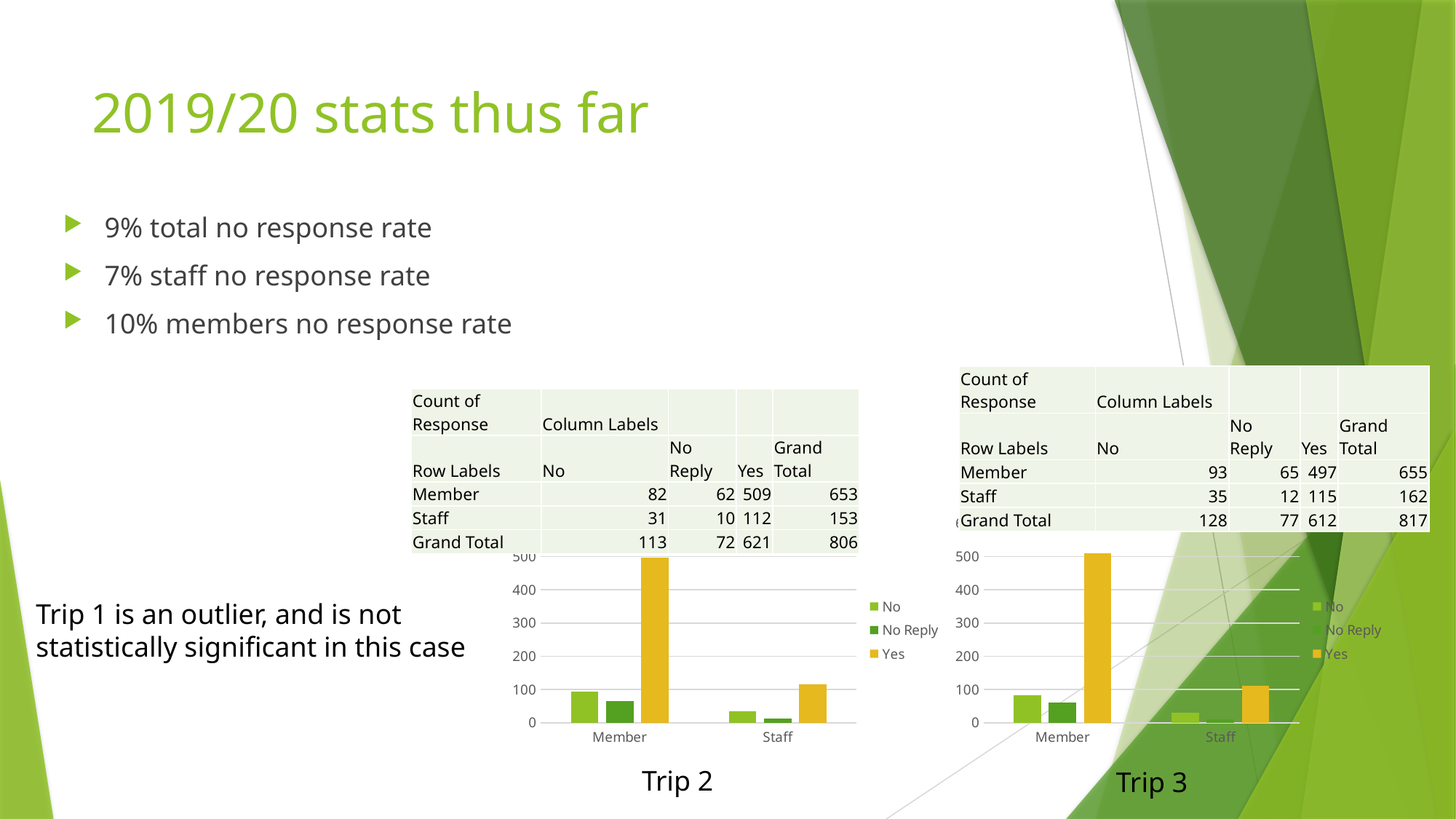
How many series does the legend of the Trip 3 chart list? 3 What kind of chart is the Trip 2 chart? bar chart In the Trip 2 chart, which series has the highest bar for Member? Yes In the Trip 2 chart, is the Yes value for Member greater or less than 400? greater In the Trip 2 chart, is the Yes value for Staff greater or less than 200? less In the Trip 3 chart, is the No value for Member greater or less than 200? less How many categories are shown on the x axis of the Trip 2 chart? 2 In the Trip 3 chart, which is larger, the Yes value for Member or the Yes value for Staff? Member In the Trip 3 chart, which series has the lowest bar for Staff? No Reply What are the legend entries of the Trip 2 chart? No, No Reply, Yes In the Trip 2 chart, which is larger, the No value for Member or the No Reply value for Staff? No value for Member